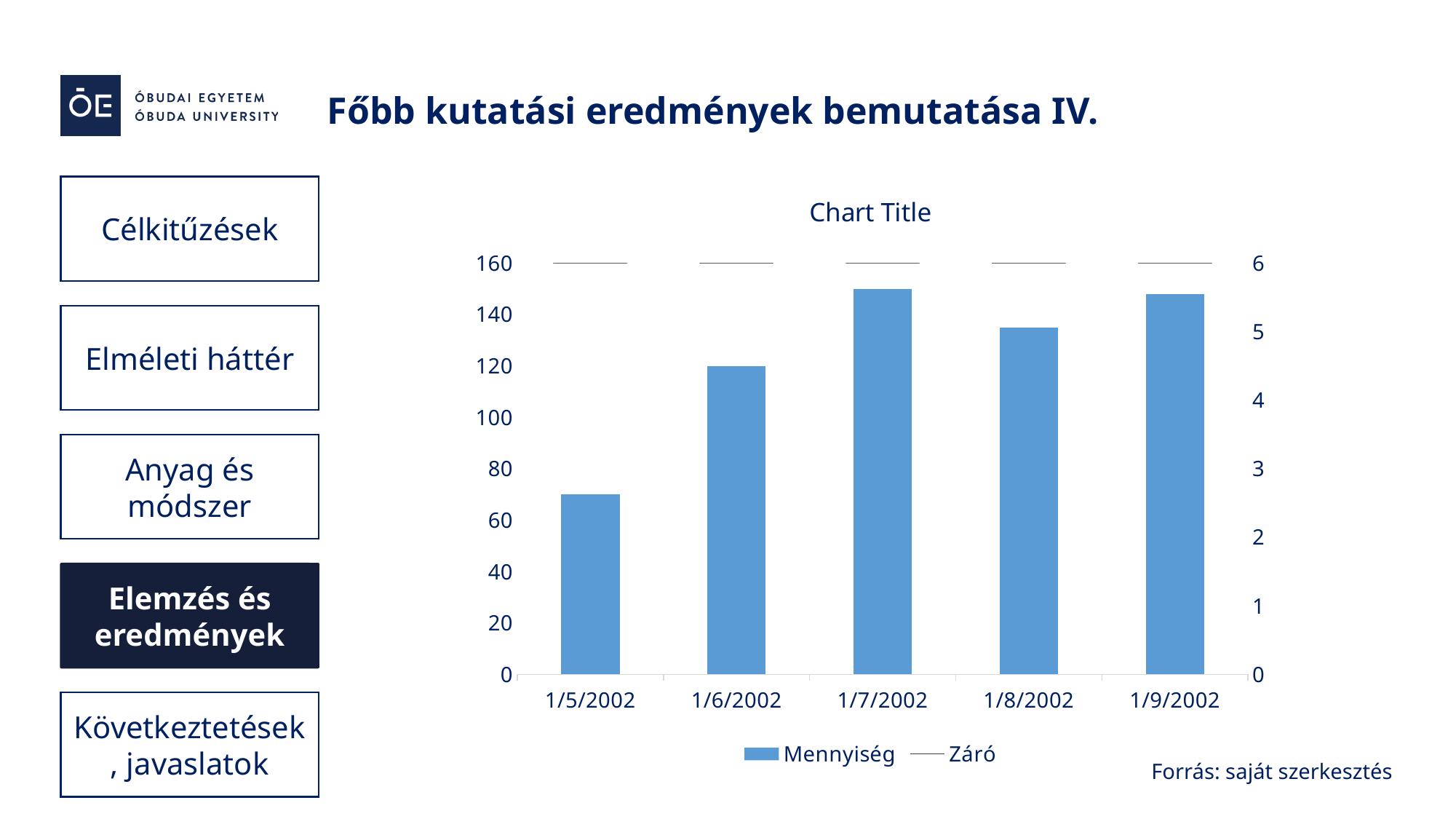
What kind of chart is shown on the slide? bar chart How many dates are shown on the x axis? 5 Which has the larger Mennyiség value, 1/5/2002 or 1/9/2002? 1/9/2002 How many series does the legend list? 2 Which date has the lowest Mennyiség bar? 1/5/2002 Do the Mennyiség bars rise or fall from 1/5/2002 to 1/7/2002? rise Is the Mennyiség value for 1/9/2002 greater or less than 140? greater Is the Mennyiség value for 1/8/2002 greater or less than 120? greater Which has the larger Mennyiség value, 1/6/2002 or 1/8/2002? 1/8/2002 What are the two entries in the chart legend? Mennyiség, Záró Is the Mennyiség value for 1/7/2002 greater or less than 140? greater